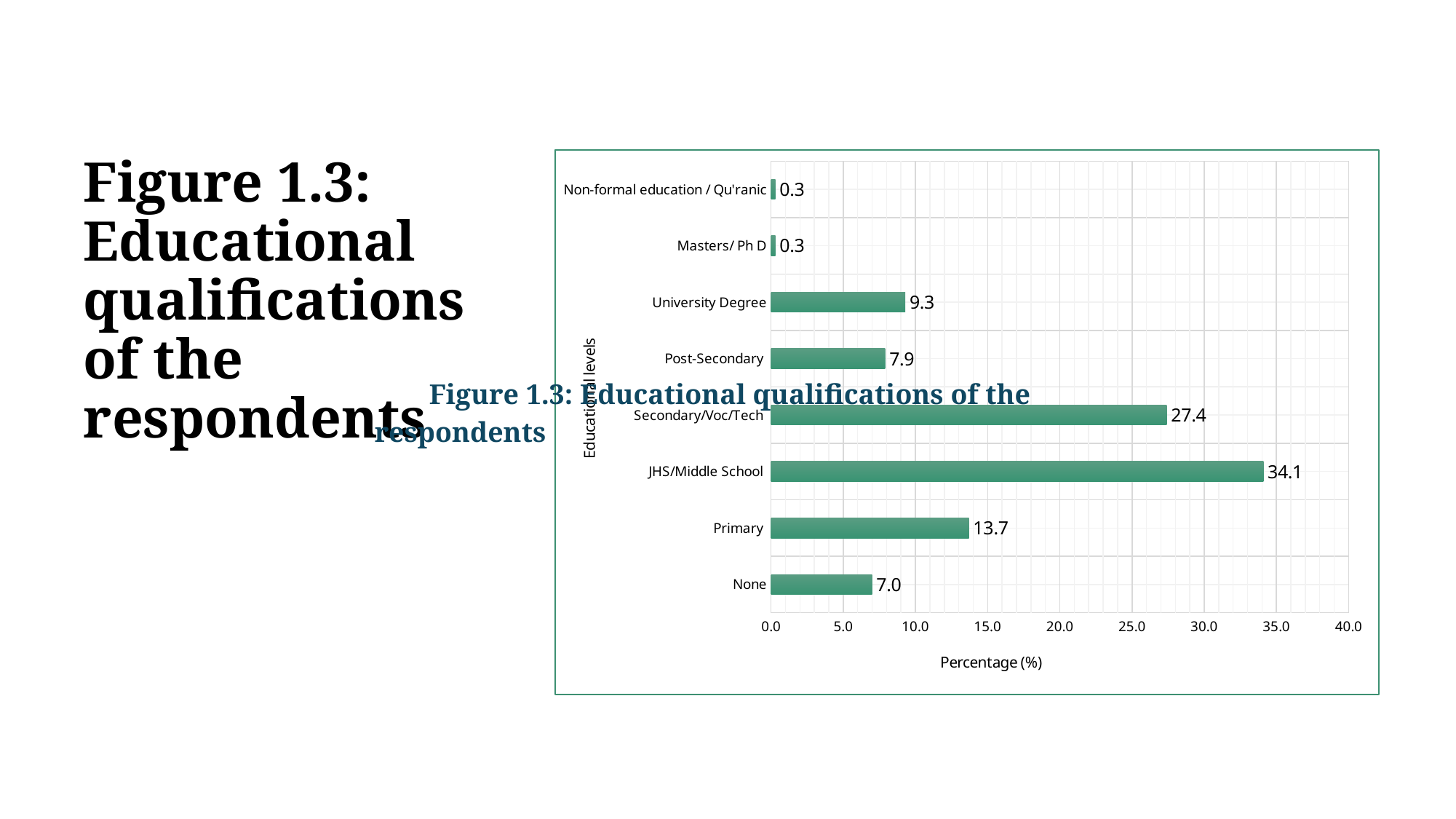
What is the label of the horizontal axis? Percentage (%) How many educational levels are shown in the chart? 8 What is the value for JHS/Middle School? 34.1 Is the value for Primary greater or less than 10.0? greater What is the value for University Degree? 9.3 What kind of chart is shown on the slide? bar chart What is the difference between the values for Primary and None? 6.7 Which educational level has the highest percentage? JHS/Middle School What is the value for Secondary/Voc/Tech? 27.4 What is the difference between the values for JHS/Middle School and Secondary/Voc/Tech? 6.7 What is the value for None? 7.0 Which is larger, the value for University Degree or the value for Post-Secondary? University Degree